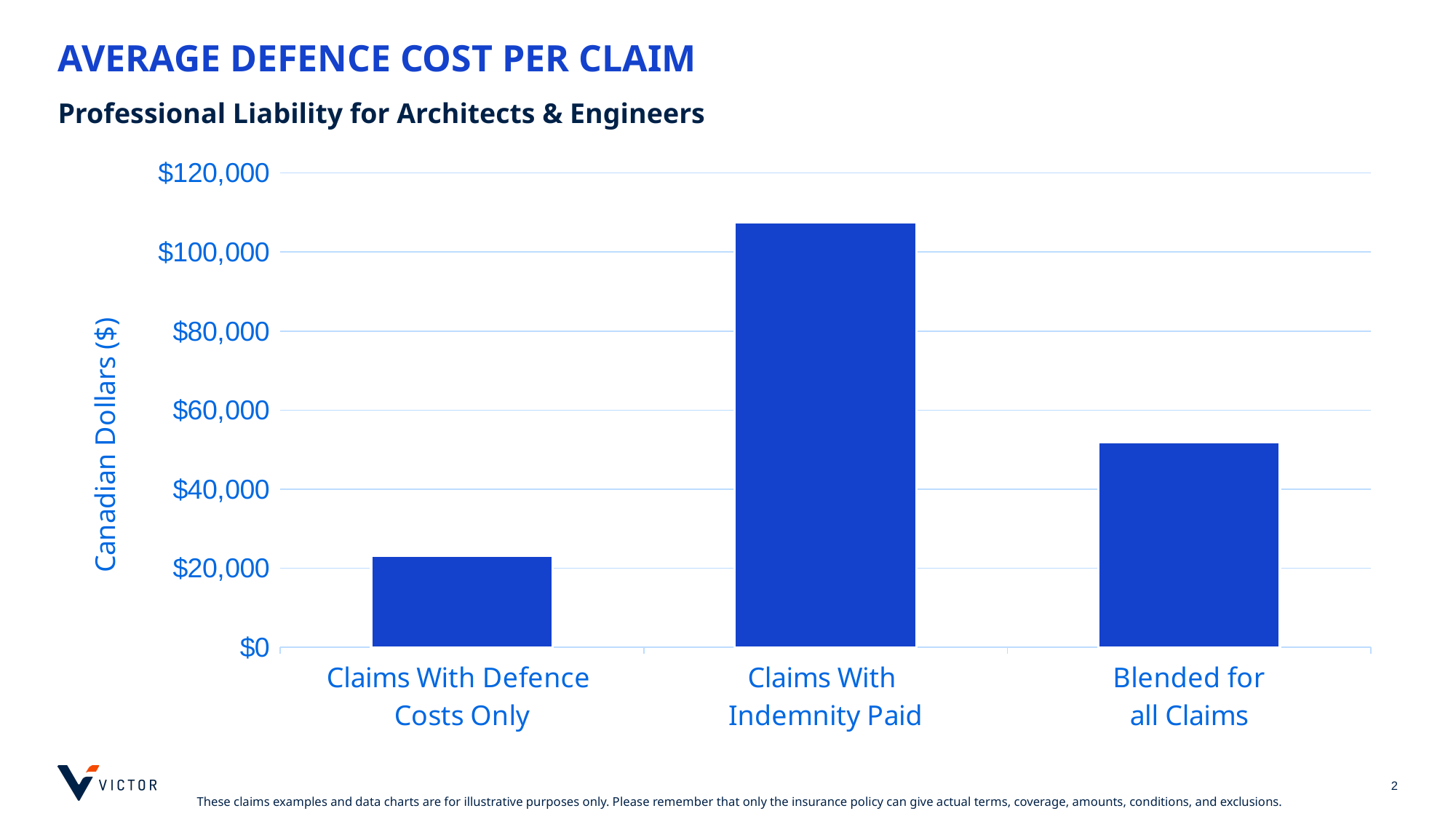
Is the value for Blended for all Claims greater or less than $60,000? less Which category has the lowest average defence cost per claim? Claims With Defence Costs Only Is the value for Blended for all Claims greater or less than $40,000? greater Is the value for Claims With Indemnity Paid greater or less than $100,000? greater Which is larger, the value for Blended for all Claims or the value for Claims With Defence Costs Only? Blended for all Claims Which category has the highest average defence cost per claim? Claims With Indemnity Paid What is the label of the vertical axis? Canadian Dollars ($) Which is larger, the value for Claims With Indemnity Paid or the value for Blended for all Claims? Claims With Indemnity Paid What is the title of the chart on the slide? AVERAGE DEFENCE COST PER CLAIM How many categories are shown on the x axis of the chart? 3 What kind of chart is shown on the slide? bar chart